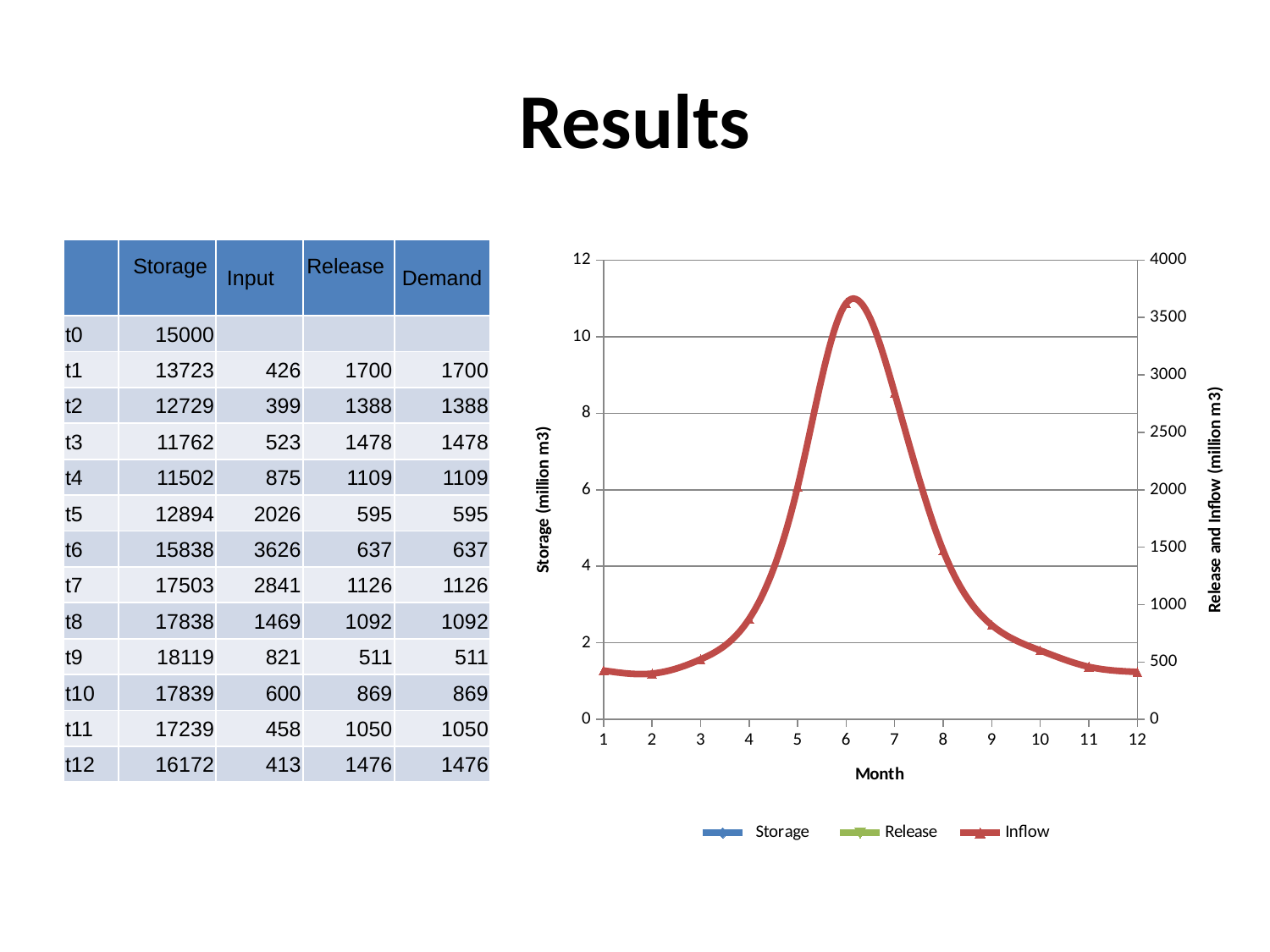
How many months are plotted along the x axis of the chart? 12 Does the Inflow line rise or fall from month 6 to month 12? fall How many series does the chart legend list? 3 Is the Inflow value at month 9 greater or less than 1000 on the right axis? less What is the title of the right-hand y axis of the chart? Release and Inflow (million m3) Is the Inflow value at month 6 greater or less than 3500 on the right axis? greater What kind of chart is shown on the slide? line chart Is the Inflow value at month 7 greater or less than 2500 on the right axis? greater Which has the larger Inflow value, month 5 or month 7? month 7 What is the title of the x axis of the chart? Month In which month does the Inflow line reach its highest value? 6